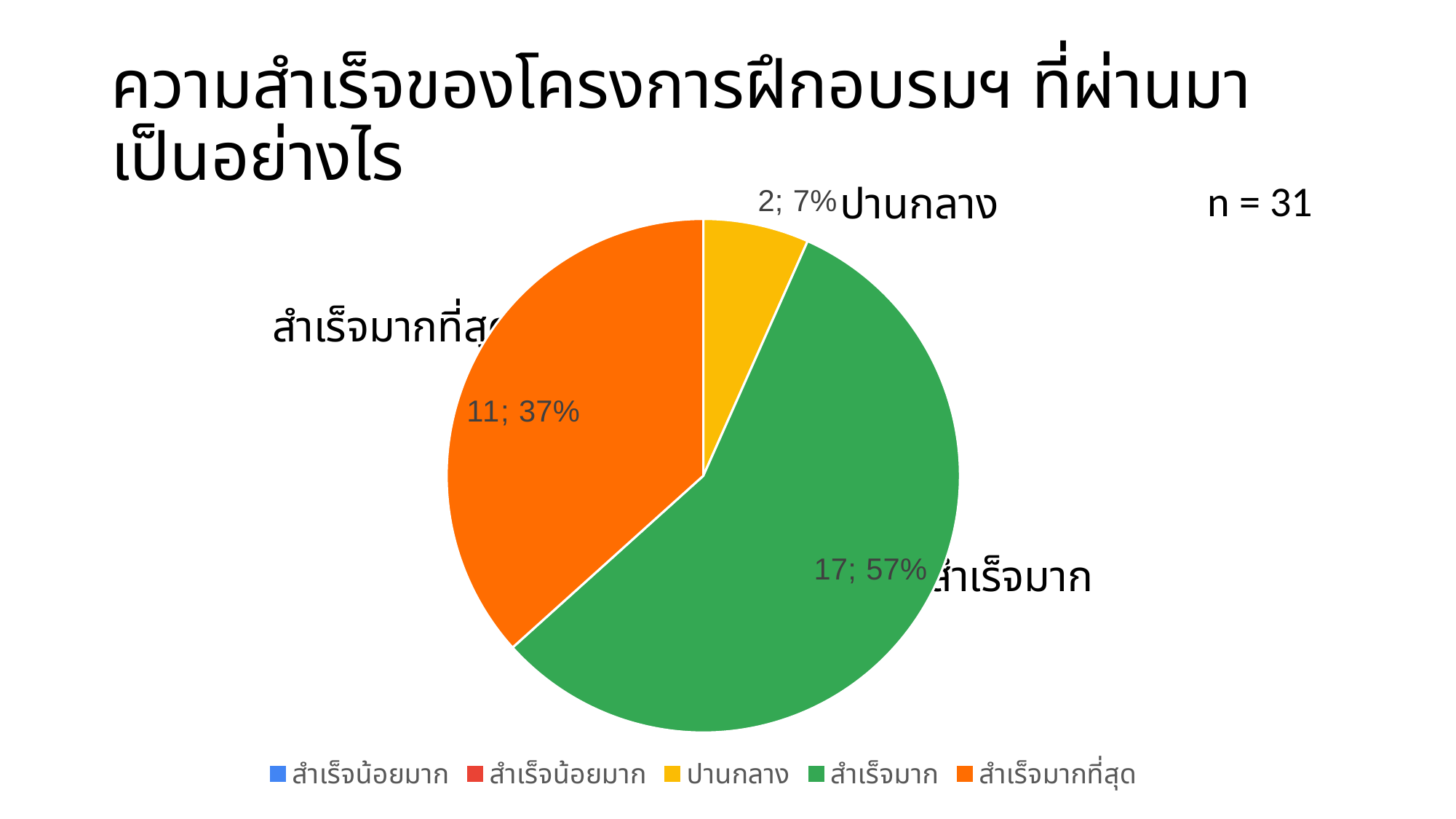
What percentage of the pie is the ปานกลาง slice? 7% Which category has the largest slice of the pie? สำเร็จมาก Which visible slice of the pie is the smallest? ปานกลาง How many entries does the legend list? 5 How many respondents chose สำเร็จมาก? 17 What kind of chart is shown on the slide? pie chart What is the value of n shown on the slide? 31 What is the difference in count between สำเร็จมาก and สำเร็จมากที่สุด? 6 What percentage of the pie is the สำเร็จมากที่สุด slice? 37% How many respondents chose ปานกลาง? 2 How many respondents chose สำเร็จมากที่สุด? 11 What percentage of the pie is the สำเร็จมาก slice? 57%